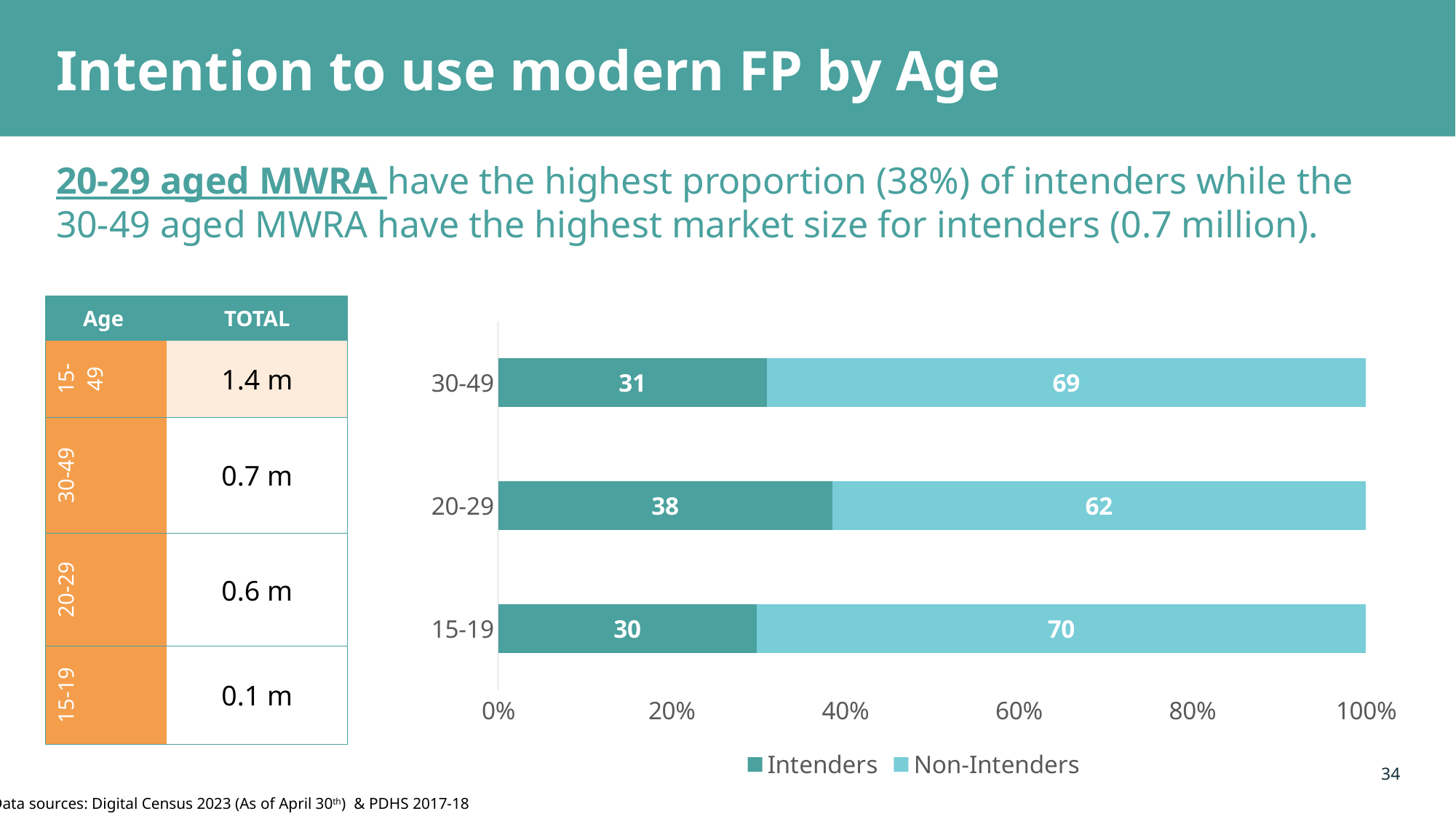
What is the Intenders value for the 15-19 age group? 30 What is the total of the stacked bar for the 15-19 age group? 100 What is the Intenders value for the 20-29 age group? 38 What are the two series named in the legend? Intenders and Non-Intenders Which age group has the highest Intenders value? 20-29 What is the Non-Intenders value for the 30-49 age group? 69 Which age group has the lowest Non-Intenders value? 20-29 How many series does the legend list? 2 What is the difference between the Non-Intenders values for 15-19 and 20-29? 8 How many age groups are shown in the chart? 3 What kind of chart is shown on the slide? Stacked bar chart Which is larger, the Intenders value for 30-49 or for 20-29? 20-29